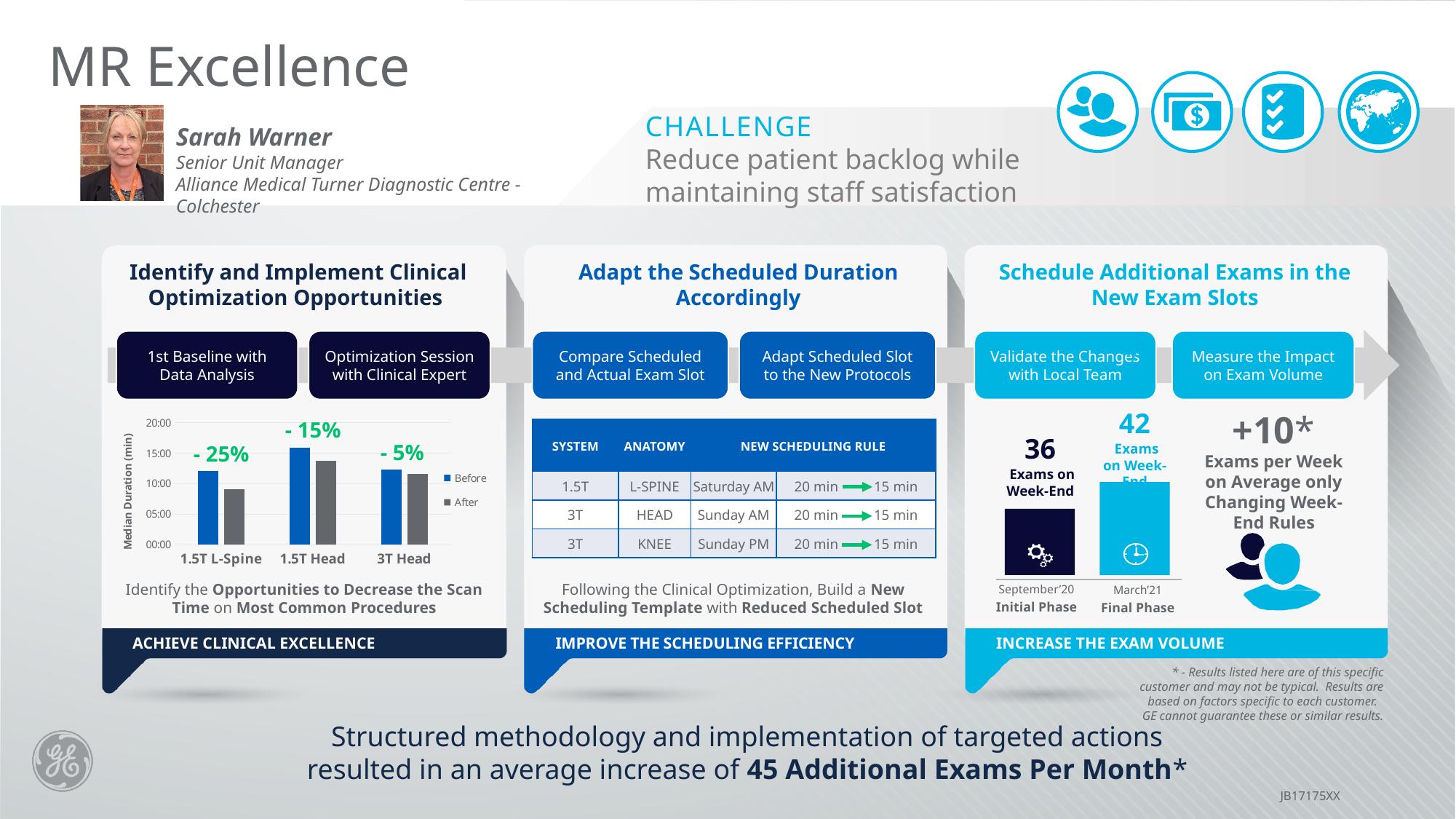
What kind of chart is shown in the 'Identify and Implement Clinical Optimization Opportunities' panel? bar chart In the 'Schedule Additional Exams in the New Exam Slots' panel, what is the difference between the exams on week-end in March'21 and September'20? 6 In the Median Duration bar chart, which procedure has the highest 'Before' median duration? 1.5T Head In the Median Duration bar chart, what percentage change is labelled above the 1.5T L-Spine bars? - 25% In the Median Duration bar chart, what percentage change is labelled above the 3T Head bars? - 5% In the Median Duration bar chart, what percentage change is labelled above the 1.5T Head bars? - 15% In the Median Duration bar chart, is the 'Before' value for 1.5T Head greater or less than 15:00? greater In the Median Duration bar chart, which procedure has the lowest 'After' median duration? 1.5T L-Spine In the Median Duration bar chart, what is the title of the vertical axis? Median Duration (min) In the Median Duration bar chart, is the 'After' value for 1.5T L-Spine greater or less than 10:00? less In the Median Duration bar chart, how many series does the legend list? 2 In the Median Duration bar chart, how many procedure categories are shown on the x axis? 3